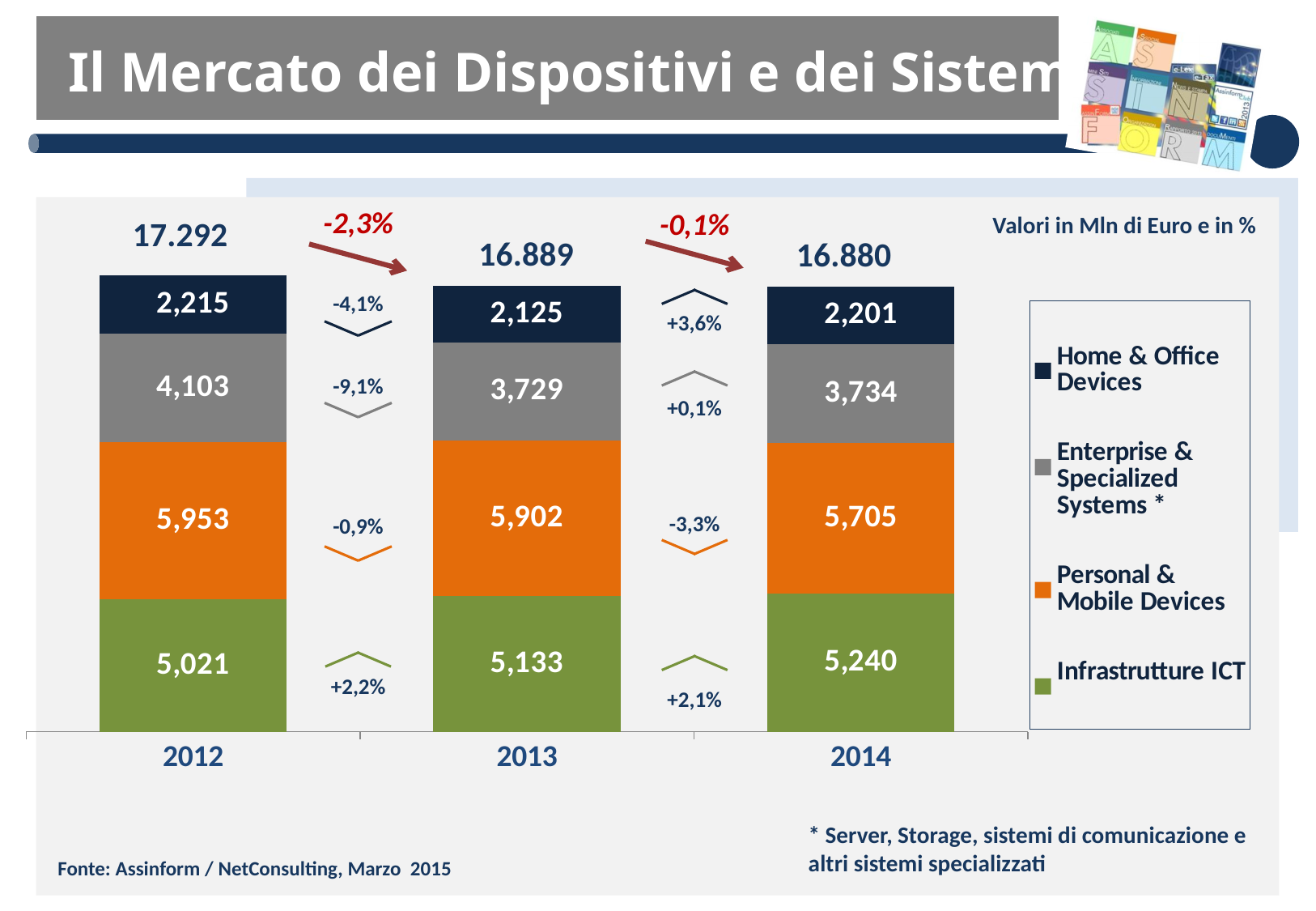
How many series does the legend list? 4 What is the difference between the Infrastrutture ICT values for 2014 and 2012? 219 What kind of chart is shown on the slide? Stacked bar chart What is the value for Infrastrutture ICT in 2014? 5,240 What percentage change is shown for Enterprise & Specialized Systems between 2012 and 2013? -9,1% Which year has the highest total value? 2012 What is the value for Enterprise & Specialized Systems in 2012? 4,103 What is the total of the stacked bar for 2014? 16.880 Which series has the lowest value in 2013? Home & Office Devices Which is larger in 2014: Personal & Mobile Devices or Infrastrutture ICT? Personal & Mobile Devices What is the total of the stacked bar for 2012? 17.292 What is the value for Personal & Mobile Devices in 2013? 5,902